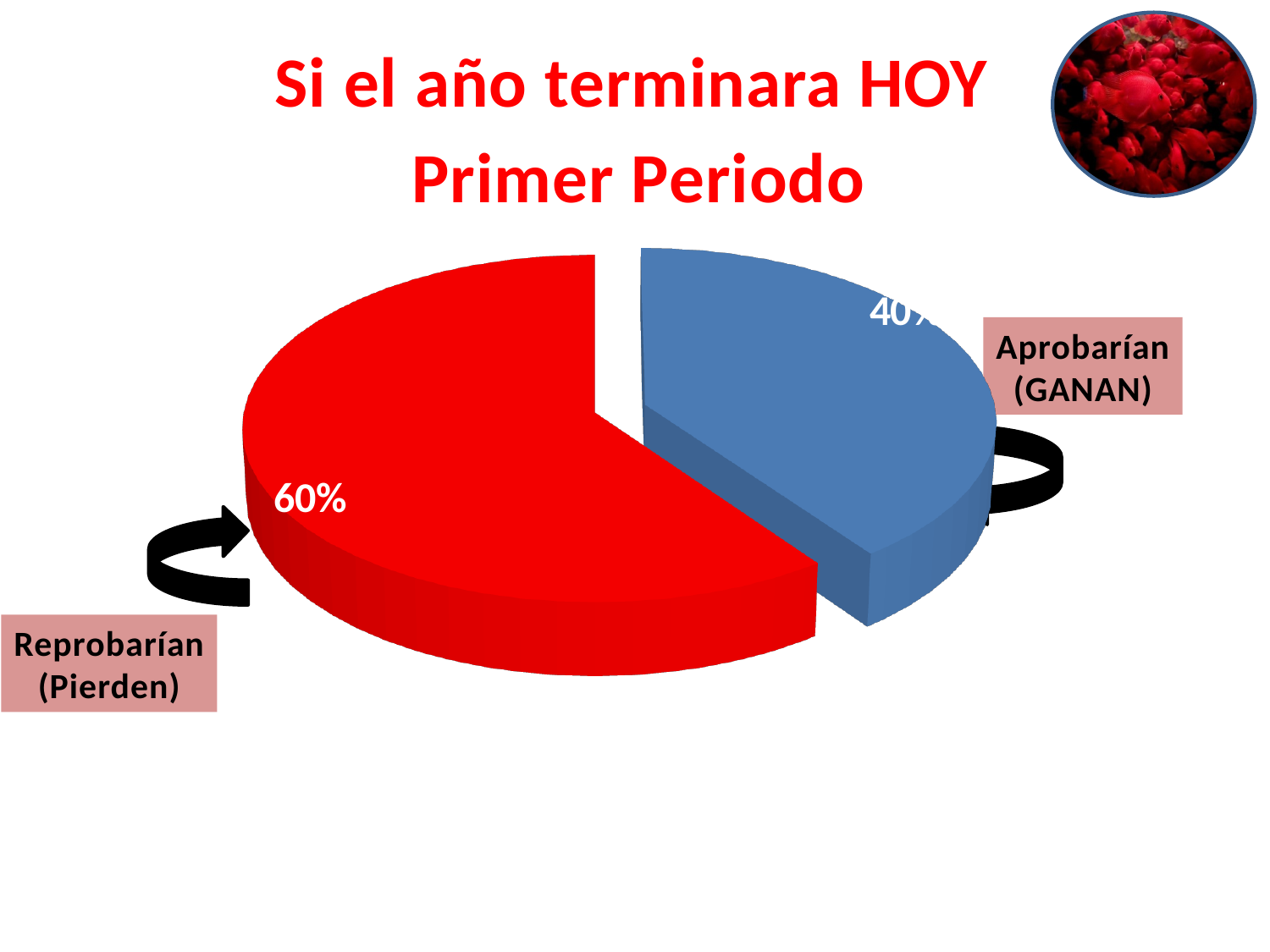
Which is larger, the share for Reprobarían (Pierden) or the share for Aprobarían (GANAN)? Reprobarían (Pierden) What percentage of the pie corresponds to Aprobarían (GANAN)? 40% What colour is the slice for Aprobarían (GANAN)? blue What is the title shown above the pie chart? Si el año terminara HOY Primer Periodo What share of the pie does the red slice represent? 60% What percentage of the pie corresponds to Reprobarían (Pierden)? 60% Which slice of the pie is the largest? Reprobarían (Pierden) How many slices does the pie chart have? 2 Which slice of the pie is the smallest? Aprobarían (GANAN) What kind of chart is shown on the slide? pie chart What is the difference in percentage points between the Reprobarían (Pierden) slice and the Aprobarían (GANAN) slice? 20